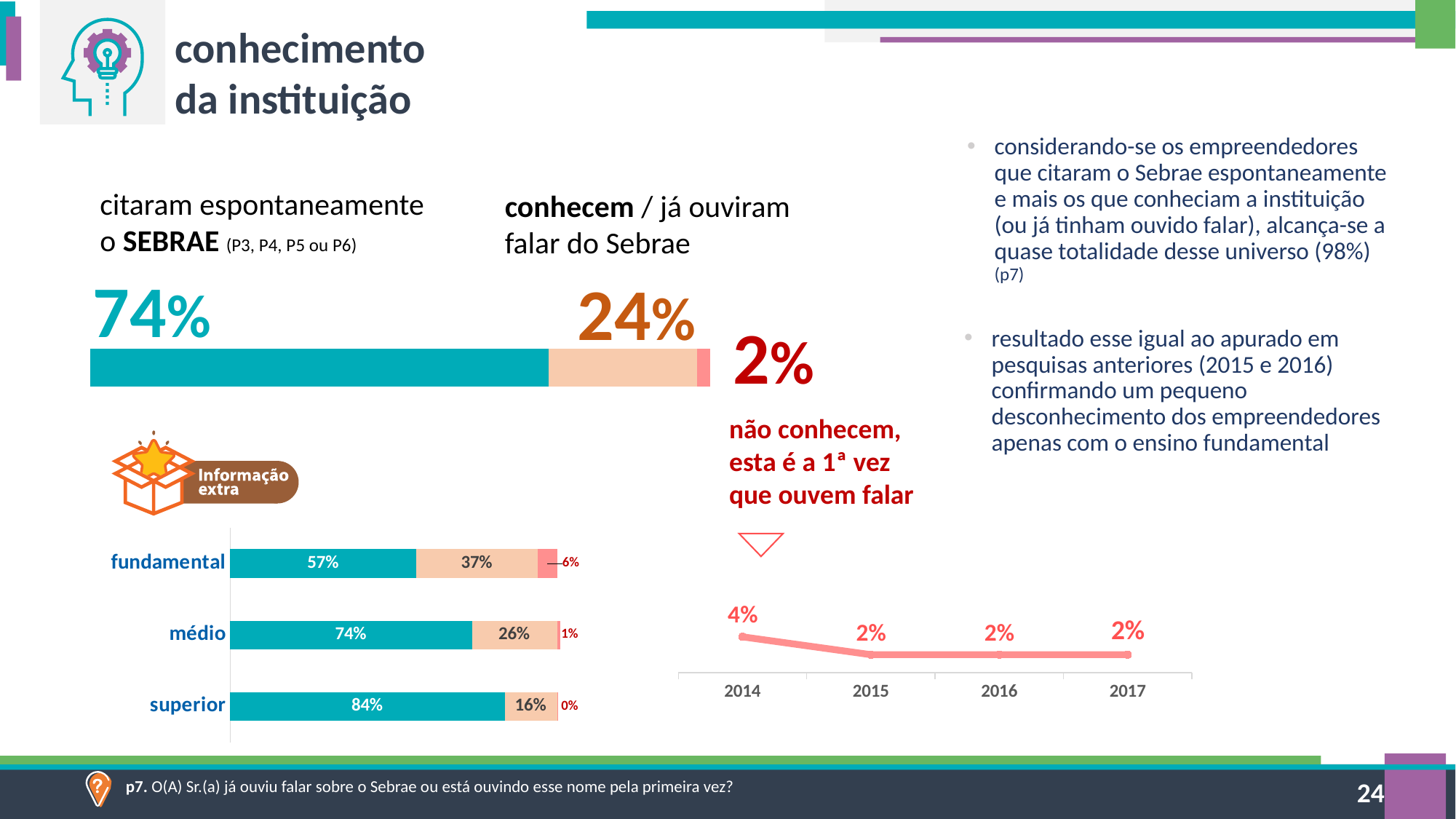
In the line chart at the bottom right, what is the difference between the 2014 value and the 2017 value? 2% What type of chart is the one at the bottom right showing values for 2014 to 2017? line chart In the stacked bar chart by education level at the bottom left, which education level has the lowest teal (spontaneously cited) value? fundamental In the stacked bar chart by education level at the bottom left, what is the value of the red segment for 'médio'? 1% In the stacked bar chart by education level at the bottom left, which education level has the highest teal (spontaneously cited) value? superior In the stacked bar chart by education level at the bottom left, what percentage of respondents with 'superior' education spontaneously cited Sebrae (teal segment)? 84% In the stacked bar chart by education level at the bottom left, what is the value of the middle (peach) segment for 'fundamental'? 37% In the stacked bar chart by education level at the bottom left, what is the difference between the teal values for 'superior' and 'fundamental'? 27% In the stacked bar chart by education level at the bottom left, how many education categories are shown? 3 In the line chart at the bottom right, what is the value for 2014? 4% In the line chart at the bottom right, how do the values change from 2014 to 2017? They fall from 4% to 2% and then stay flat In the top stacked bar, what percentage of respondents 'conhecem / já ouviram falar do Sebrae'? 24%